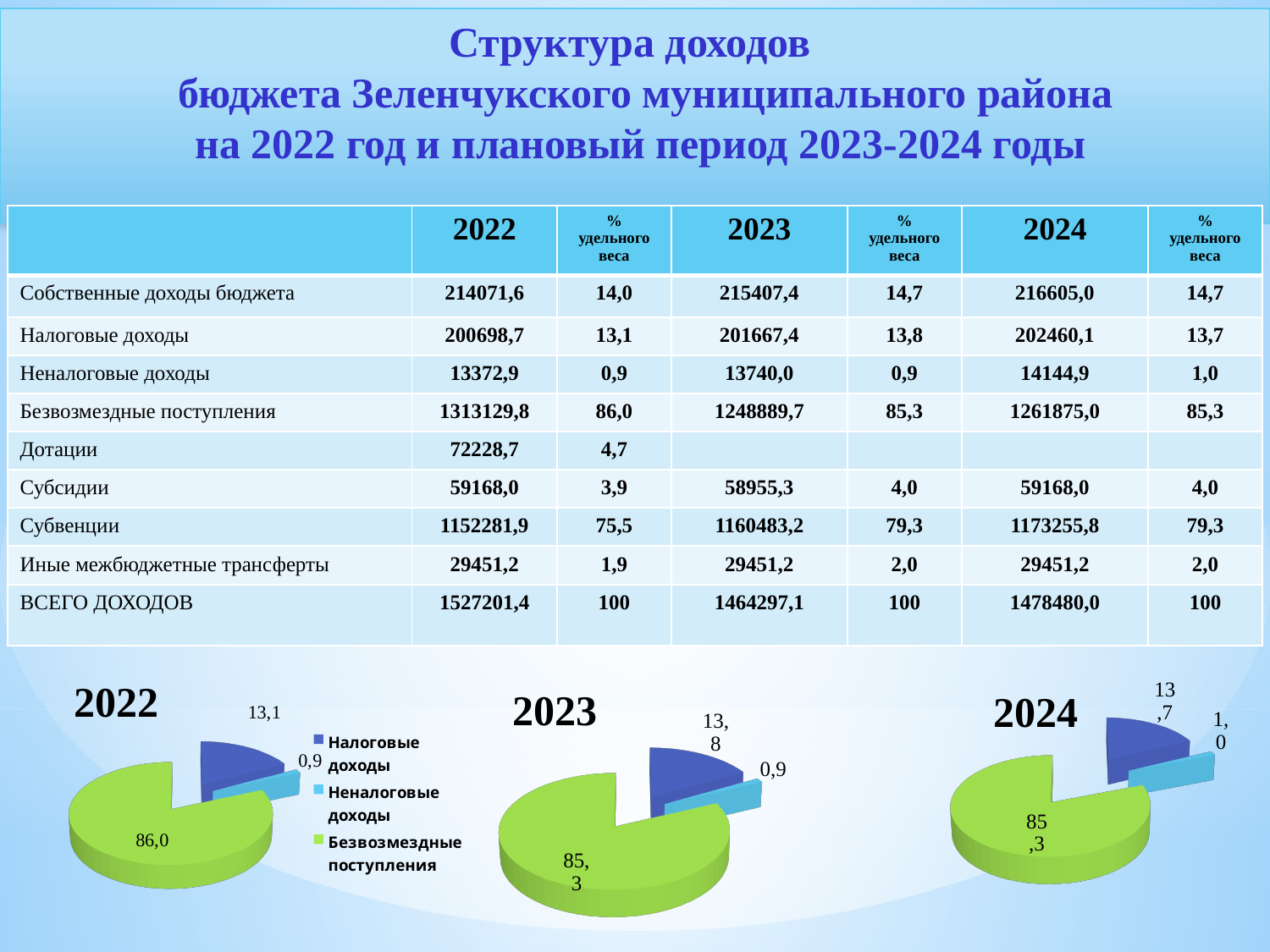
How many slices does the 2023 pie chart have? 3 In the 2023 pie chart, what value is shown for Неналоговые доходы? 0,9 How many entries does the legend next to the 2022 pie chart list? 3 What type of chart is used for the 2022 data at the bottom of the slide? Pie chart In the 2022 pie chart, which category has the smallest slice? Неналоговые доходы In the 2022 pie chart, which is larger: Налоговые доходы or Неналоговые доходы? Налоговые доходы In the 2024 pie chart, what is the difference between the values for Налоговые доходы and Неналоговые доходы? 12,7 In the 2022 pie chart, what value is shown for Безвозмездные поступления? 86,0 In the 2024 pie chart, what value is shown for Налоговые доходы? 13,7 In the 2023 pie chart, which category has the largest slice? Безвозмездные поступления In the 2022 pie chart, what value is shown for Налоговые доходы? 13,1 In the 2024 pie chart, what value is shown for Безвозмездные поступления? 85,3